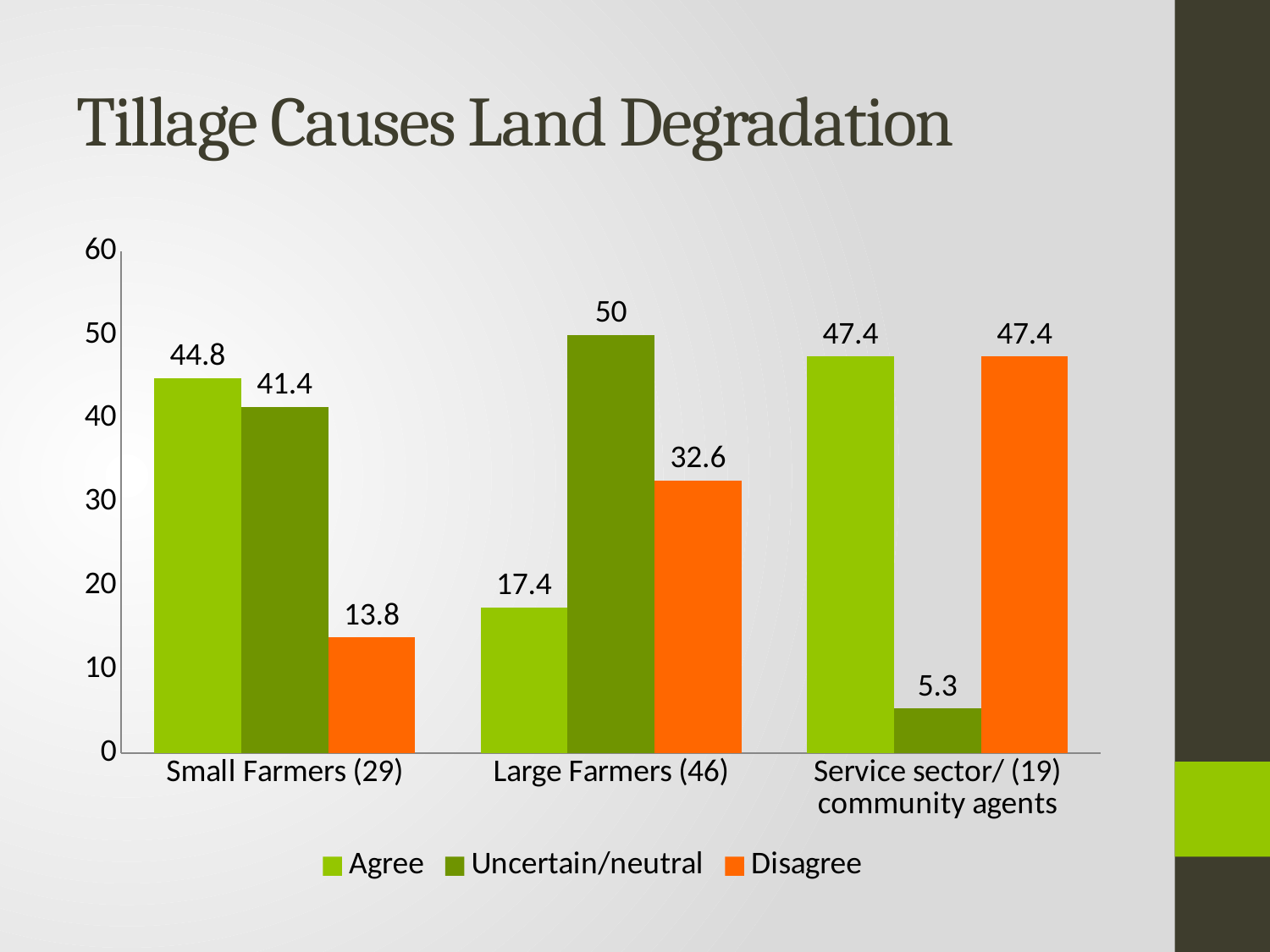
What is the Agree value for Small Farmers (29)? 44.8 What is the title of the slide? Tillage Causes Land Degradation Which category has the highest Disagree value? Service sector/ (19) community agents What is the difference between the Uncertain/neutral and Disagree values for Large Farmers (46)? 17.4 What is the Uncertain/neutral value for Large Farmers (46)? 50 What kind of chart is shown on the slide? bar chart How many categories are shown on the x axis? 3 Which category has the lowest Uncertain/neutral value? Service sector/ (19) community agents How many series does the legend list? 3 What is the Disagree value for Service sector/ (19) community agents? 47.4 For Small Farmers (29), which is larger: Agree or Disagree? Agree Is the Agree value for Large Farmers (46) greater or less than 20? less